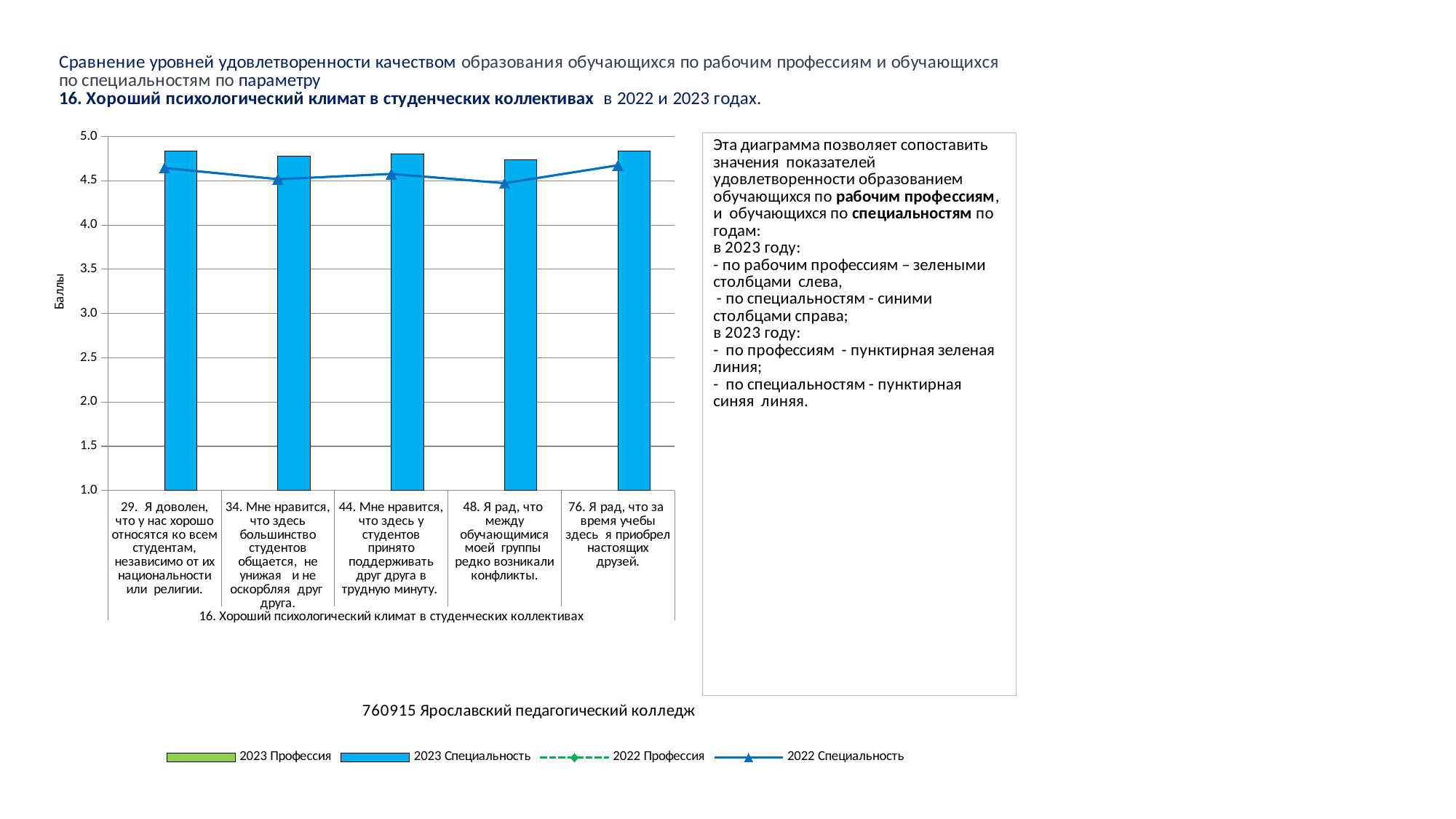
Which is larger: the 2023 Специальность bar for category 29 or for category 48? category 29 Is the 2022 Специальность line value for category 76 greater or less than 4.5? greater How many categories (questions) are shown along the x axis of the chart? 5 Is the 2022 Специальность line value for category 29 greater or less than 4.5? greater What is the title of the y axis of the chart? Баллы What is the title shown below the chart? 760915 Ярославский педагогический колледж For category 29, which is larger: the 2023 Специальность bar or the 2022 Специальность line value? 2023 Специальность bar Is the 2023 Специальность bar for category 29 greater or less than 4.5? greater What kind of chart is shown on the slide? bar chart (with a line series) How many series does the chart legend list? 4 Which category has the lowest 2023 Специальность bar? 48. Я рад, что между обучающимися моей группы редко возникали конфликты.